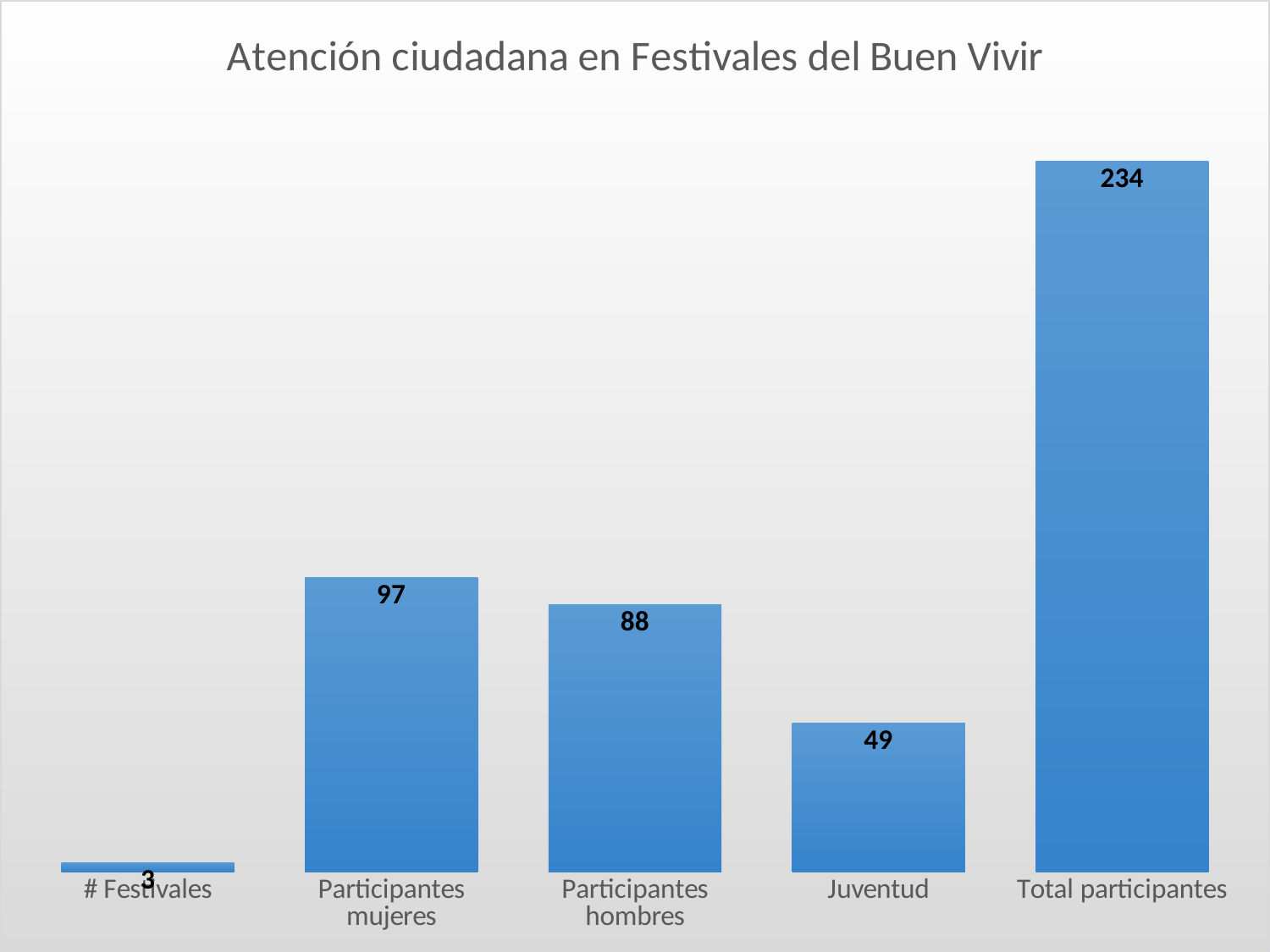
What is the value for # Festivales? 3 What is the value for Participantes mujeres? 97 What is the value for Juventud? 49 Which is larger, Participantes hombres or Juventud? Participantes hombres What is the title of the chart? Atención ciudadana en Festivales del Buen Vivir What is the value for Participantes hombres? 88 What is the difference between Participantes mujeres and Participantes hombres? 9 What is the value for Total participantes? 234 Which category has the highest value? Total participantes What kind of chart is this? Bar chart How many categories are shown on the chart? 5 Which category has the lowest value? # Festivales